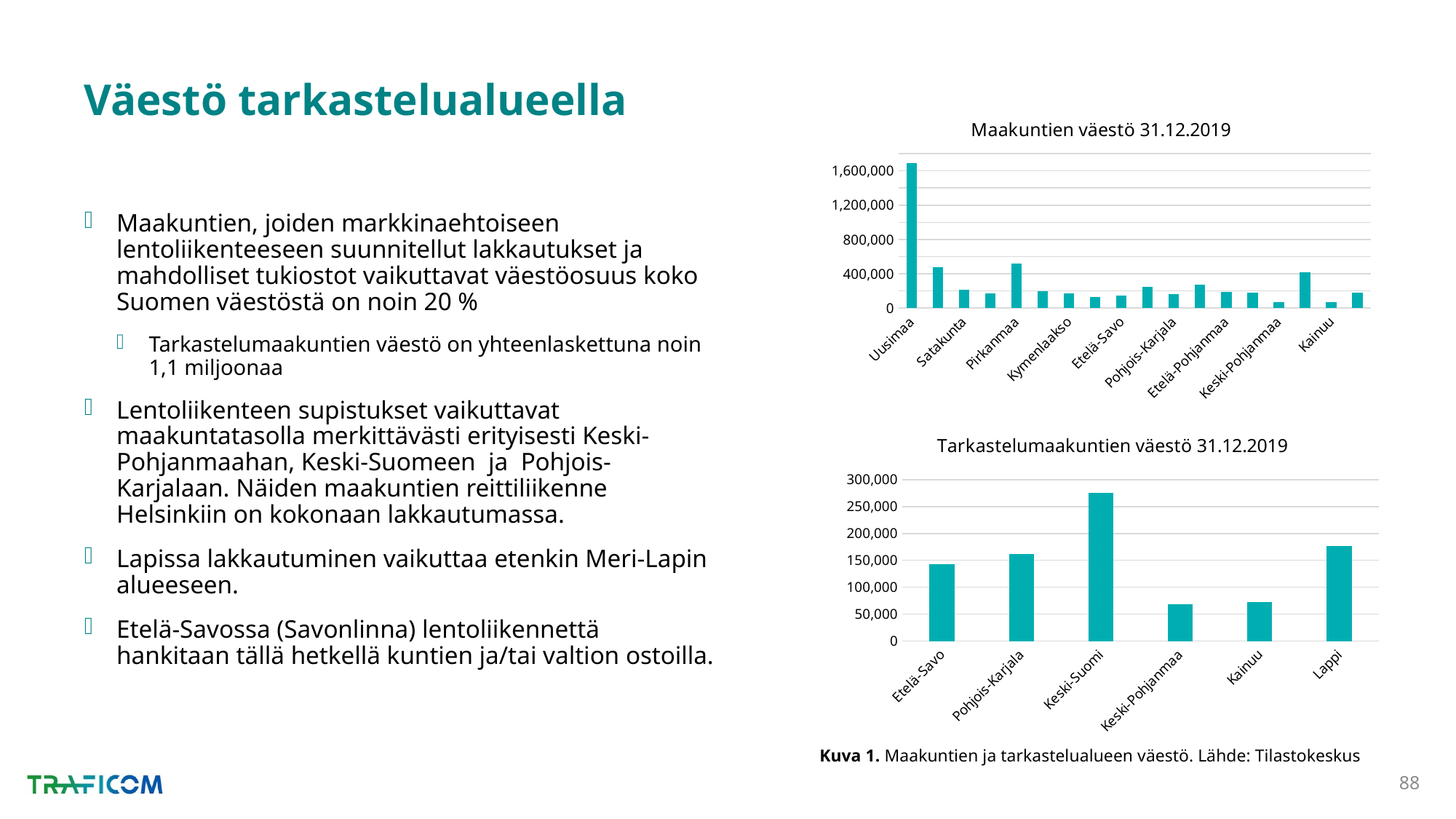
In the 'Tarkastelumaakuntien väestö 31.12.2019' chart, is the value for Keski-Pohjanmaa greater or less than 100,000? less What kind of chart is the 'Tarkastelumaakuntien väestö 31.12.2019' chart? bar chart In the 'Tarkastelumaakuntien väestö 31.12.2019' chart, which is larger, Keski-Suomi or Etelä-Savo? Keski-Suomi What is the title of the top chart on the slide? Maakuntien väestö 31.12.2019 In the 'Tarkastelumaakuntien väestö 31.12.2019' chart, is the value for Lappi greater or less than 150,000? greater In the 'Tarkastelumaakuntien väestö 31.12.2019' chart, which is larger, Lappi or Pohjois-Karjala? Lappi In the 'Tarkastelumaakuntien väestö 31.12.2019' chart, is the value for Etelä-Savo greater or less than 150,000? less In the 'Tarkastelumaakuntien väestö 31.12.2019' chart, which region has the largest population? Keski-Suomi In the 'Maakuntien väestö 31.12.2019' chart, which region has the largest population? Uusimaa In the 'Tarkastelumaakuntien väestö 31.12.2019' chart, how many regions are shown? 6